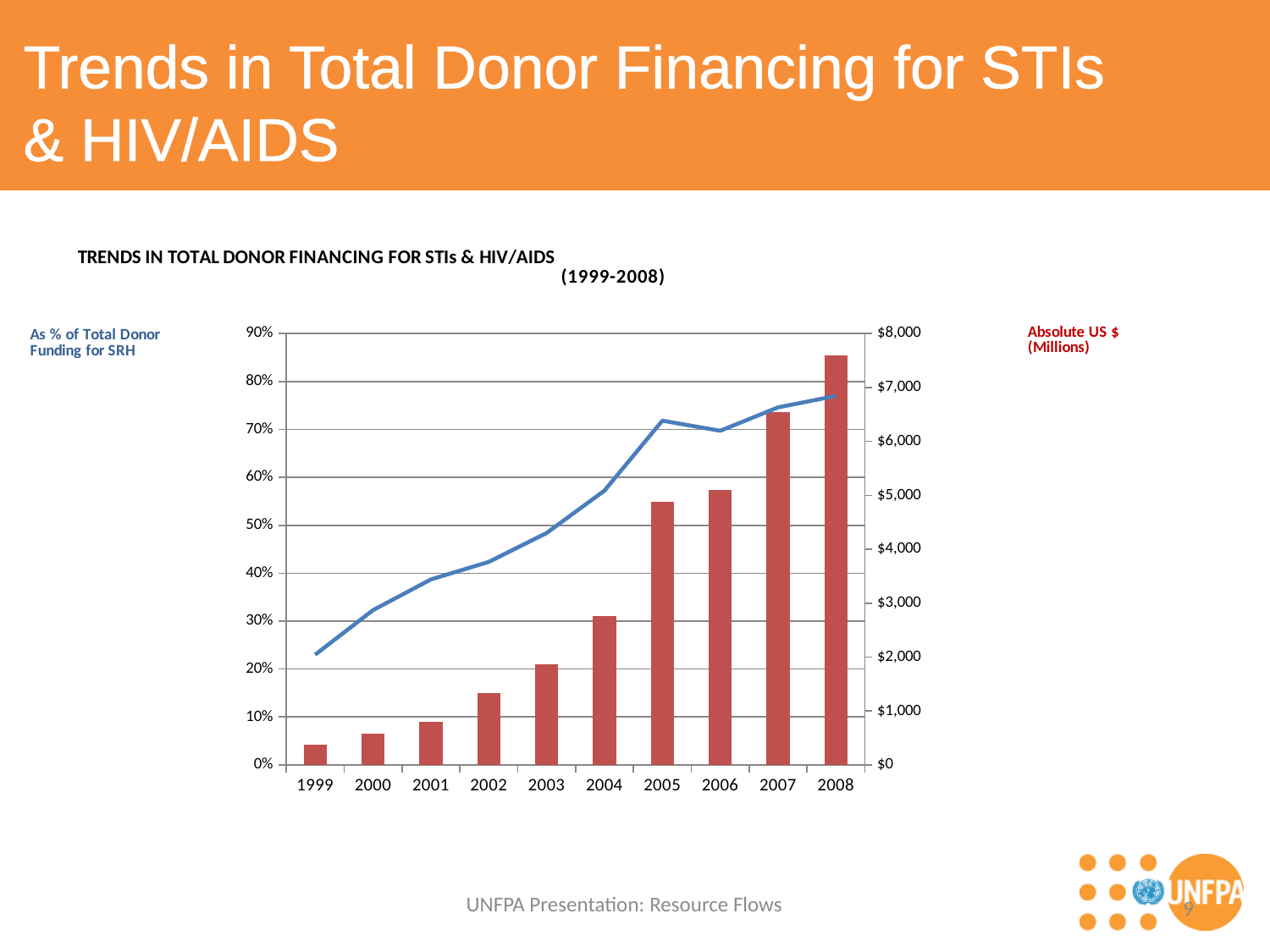
What kind of chart is shown on the slide? A combination bar and line chart Which year has the higher absolute US $ (millions) bar, 2006 or 2007? 2007 Is the absolute US $ (millions) bar for 2008 greater or less than $7,000? greater Is the absolute US $ (millions) bar for 2007 greater or less than $6,000? greater Do the absolute US $ (millions) bars generally rise or fall from 1999 to 2008? rise How many years are shown along the x axis of the chart? 10 Is the percentage of total donor funding for SRH in 2004 greater or less than 50%? greater Which year has the shortest bar for absolute US $ (millions)? 1999 Which year has the tallest bar for absolute US $ (millions)? 2008 What does the right-hand vertical axis of the chart measure? Absolute US $ (Millions)